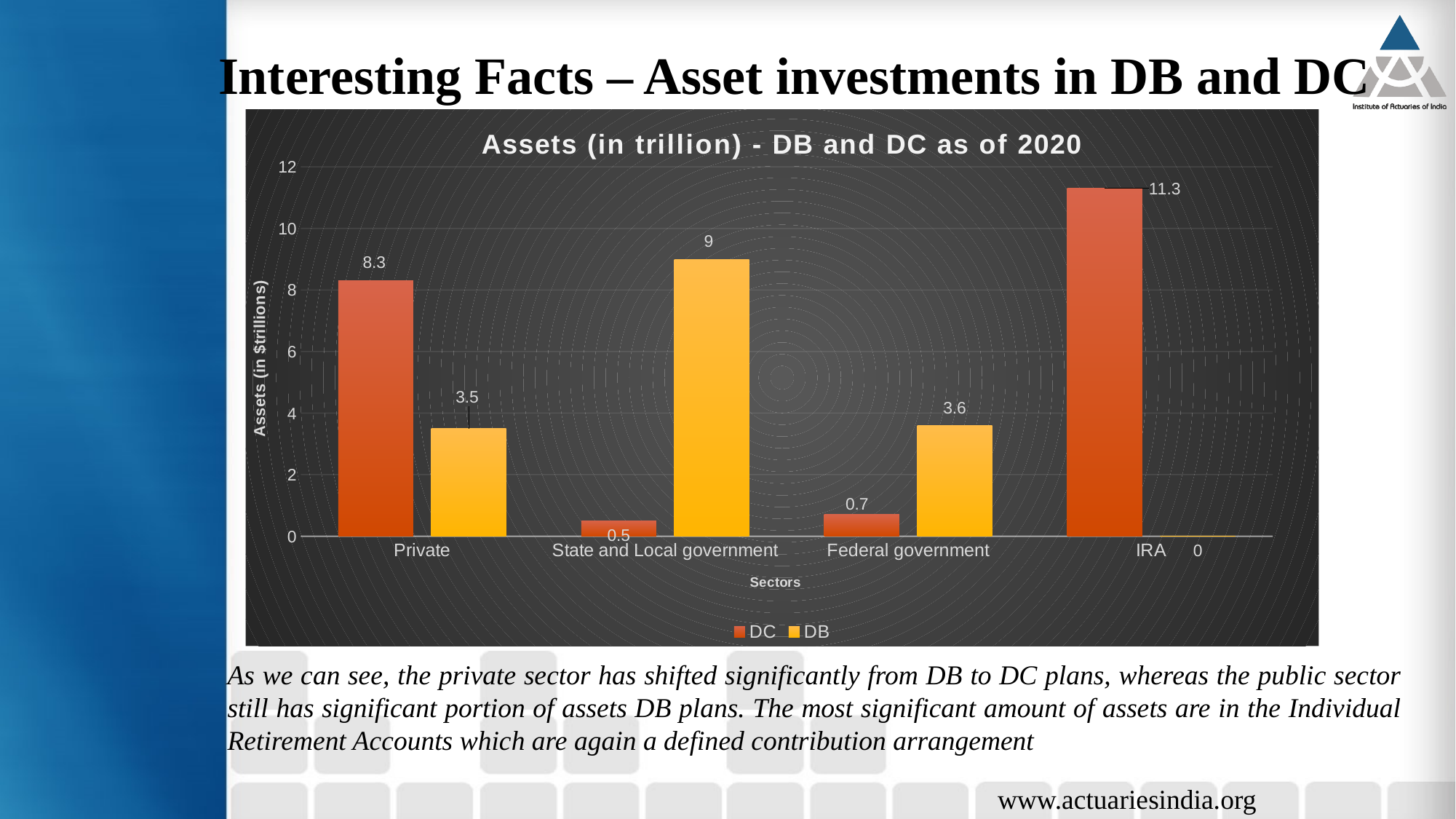
What kind of chart is shown on the slide? Bar chart How many series does the legend list? 2 What is the difference between the DC and DB values for Private? 4.8 Which is larger for Federal government, the DC value or the DB value? DB What is the DB value for State and Local government? 9 Which sector has the highest DC value? IRA Which sector has the lowest DB value? IRA What is the DC value for IRA? 11.3 What is the DC value for Private? 8.3 What is the DB value for Federal government? 3.6 How many sectors are shown on the x axis? 4 What is the title of the chart? Assets (in trillion) - DB and DC as of 2020